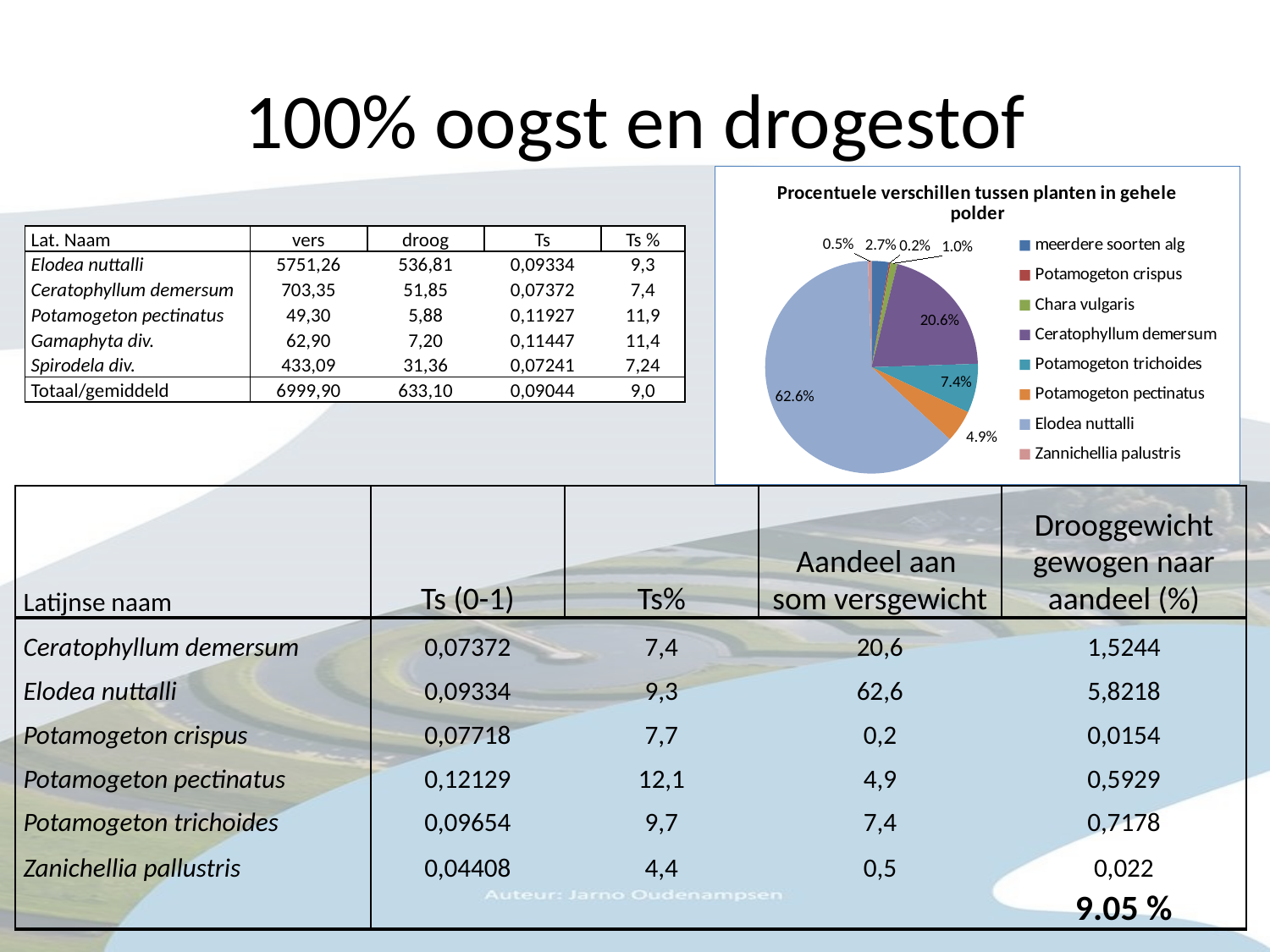
What percentage does the pie chart show for Potamogeton pectinatus? 4.9% What percentage does the pie chart show for Elodea nuttalli? 62.6% What percentage does the pie chart show for Ceratophyllum demersum? 20.6% How many slices does the pie chart have? 8 What percentage does the pie chart show for Potamogeton trichoides? 7.4% What type of chart is shown on the slide? pie chart How many entries does the legend of the pie chart list? 8 Which plant has the largest slice in the pie chart? Elodea nuttalli What is the title of the pie chart? Procentuele verschillen tussen planten in gehele polder Which slice is larger in the pie chart: Potamogeton trichoides or Potamogeton pectinatus? Potamogeton trichoides Which plant has the smallest slice in the pie chart? Potamogeton crispus What is the difference in percentage points between the Elodea nuttalli slice and the Ceratophyllum demersum slice? 42.0%